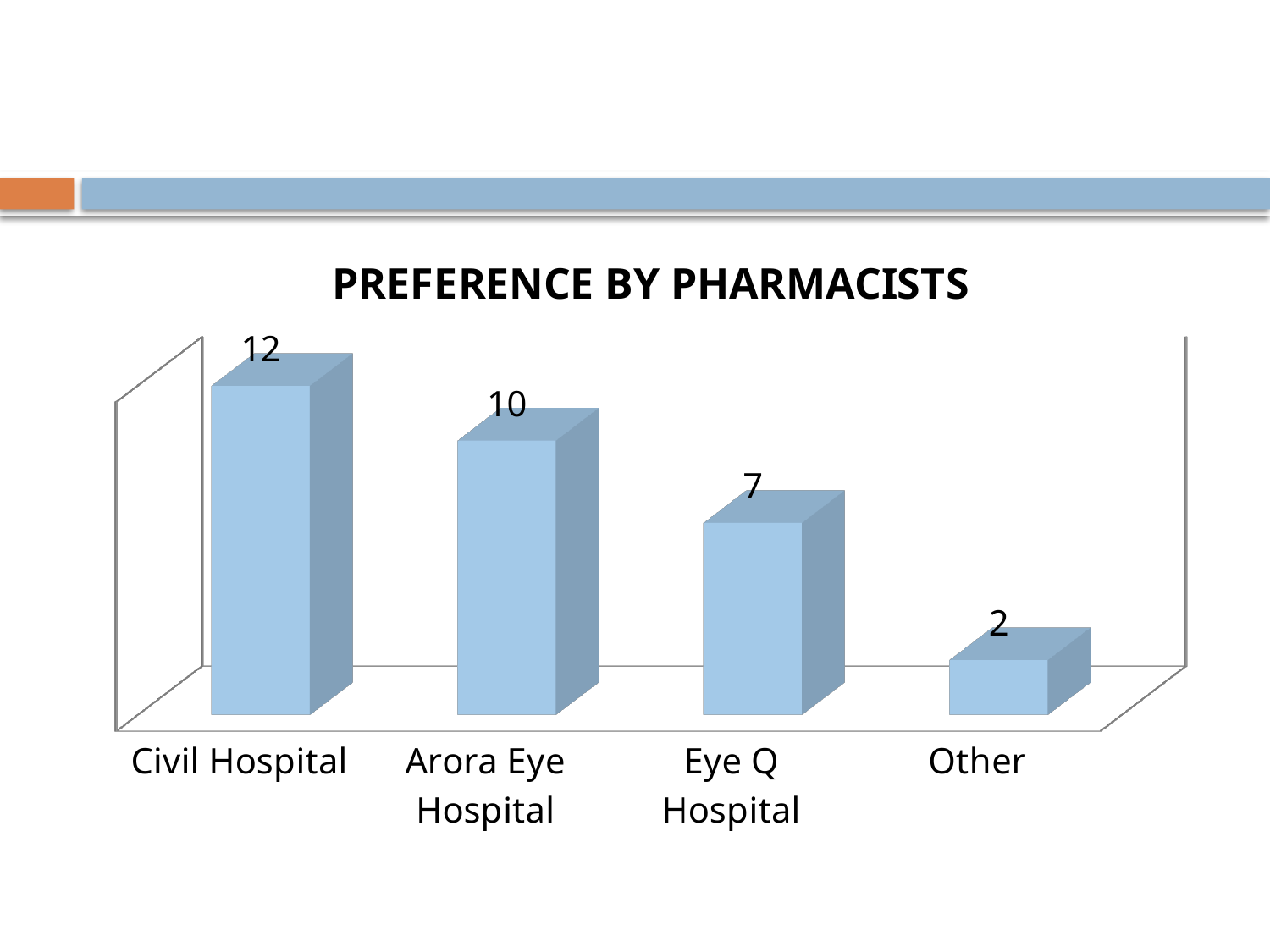
What is the value for Eye Q Hospital? 7 What is the difference between the values for Civil Hospital and Eye Q Hospital? 5 How many categories are shown in the chart? 4 What is the value for Civil Hospital? 12 Which is larger, the value for Arora Eye Hospital or the value for Eye Q Hospital? Arora Eye Hospital Which category has the lowest value? Other Which category has the highest value? Civil Hospital What is the value for Other? 2 What is the title of the chart? PREFERENCE BY PHARMACISTS What kind of chart is shown on the slide? Bar chart What is the difference between the values for Arora Eye Hospital and Other? 8 What is the value for Arora Eye Hospital? 10